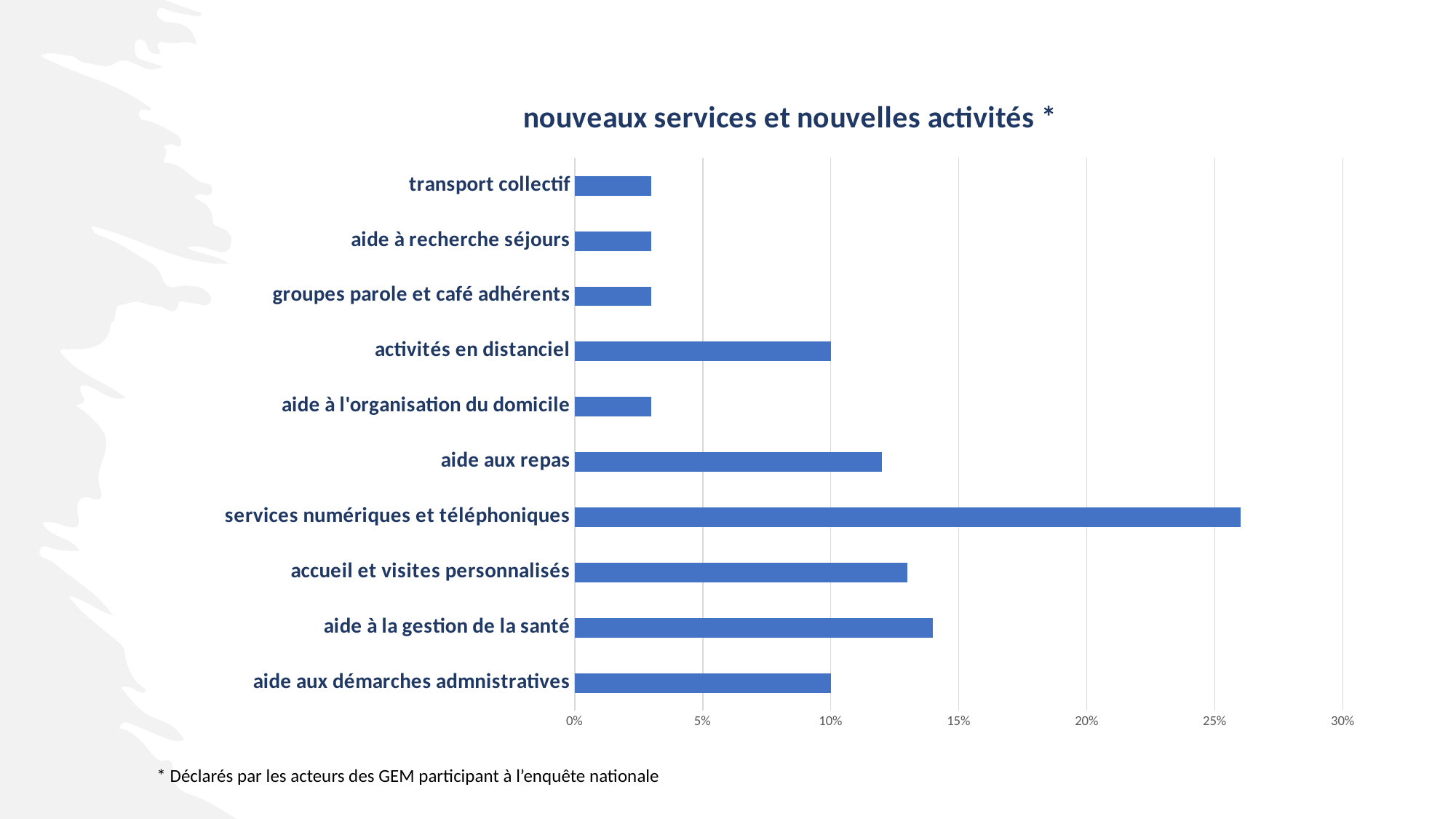
Is the value for services numériques et téléphoniques greater or less than 25%? greater What is the title of the chart? nouveaux services et nouvelles activités * Which is larger, the value for aide à la gestion de la santé or the value for aide aux repas? aide à la gestion de la santé Is the value for aide à la gestion de la santé greater or less than 15%? less Which category has the highest value? services numériques et téléphoniques Is the value for transport collectif greater or less than 5%? less Which is larger, the value for services numériques et téléphoniques or the value for accueil et visites personnalisés? services numériques et téléphoniques What kind of chart is shown on the slide? bar chart What is the value for activités en distanciel? 10% How many categories are plotted in the chart? 10